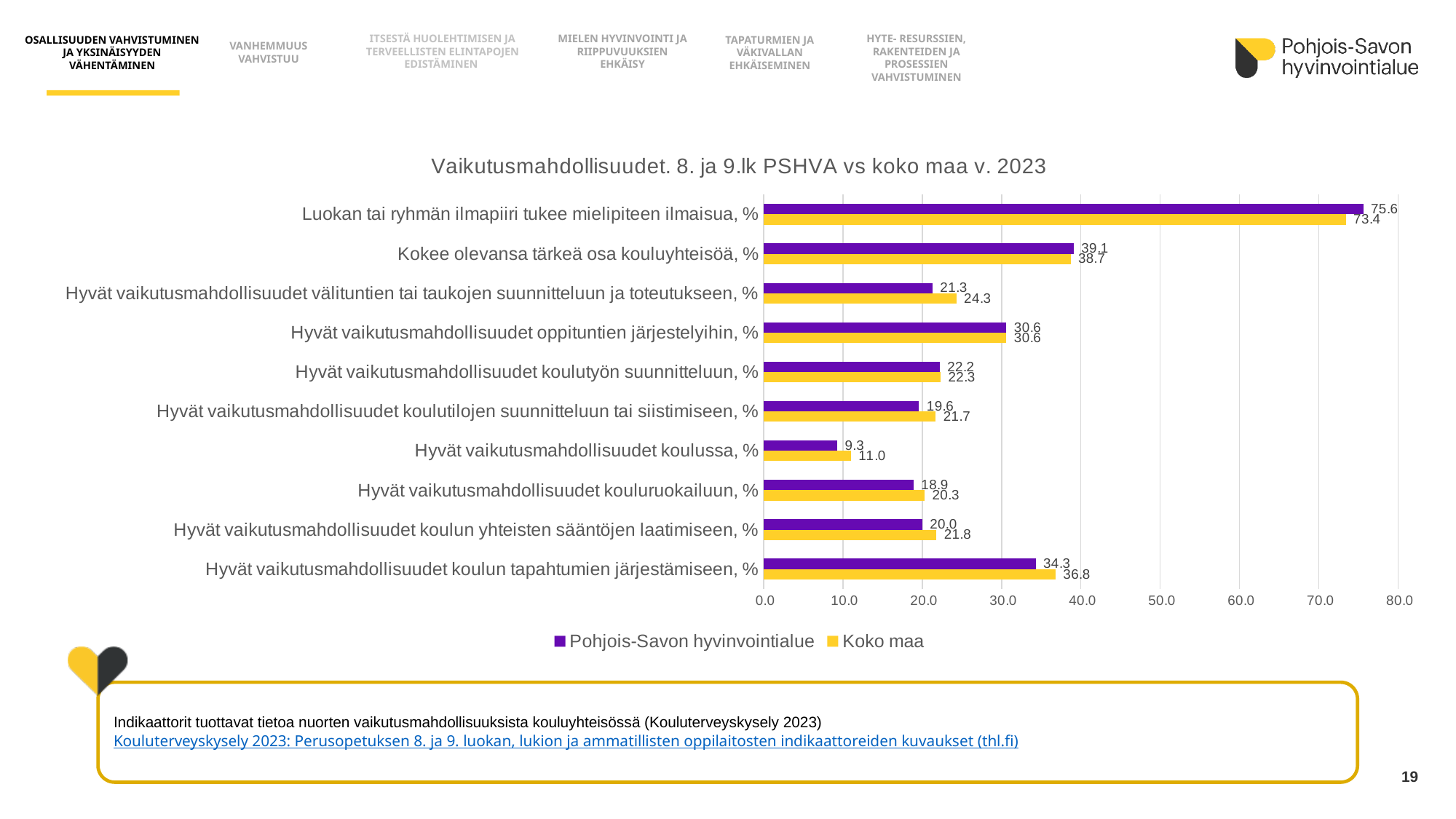
Is the Pohjois-Savon hyvinvointialue value for "Kokee olevansa tärkeä osa kouluyhteisöä, %" greater or less than 30.0? greater What is the difference between the Koko maa and Pohjois-Savon hyvinvointialue values for "Hyvät vaikutusmahdollisuudet välituntien tai taukojen suunnitteluun ja toteutukseen, %"? 3.0 Which category has the highest value for Pohjois-Savon hyvinvointialue? Luokan tai ryhmän ilmapiiri tukee mielipiteen ilmaisua, % What type of chart is shown on the slide? Bar chart Which category has the lowest value for Koko maa? Hyvät vaikutusmahdollisuudet koulussa, % What is the value for Pohjois-Savon hyvinvointialue for "Luokan tai ryhmän ilmapiiri tukee mielipiteen ilmaisua, %"? 75.6 What is the Koko maa value for "Hyvät vaikutusmahdollisuudet koulun tapahtumien järjestämiseen, %"? 36.8 What is the title of the chart? Vaikutusmahdollisuudet. 8. ja 9.lk PSHVA vs koko maa v. 2023 How many series does the legend list? 2 How many categories are shown on the chart? 10 What is the Koko maa value for "Hyvät vaikutusmahdollisuudet koulussa, %"? 11.0 For "Hyvät vaikutusmahdollisuudet kouluruokailuun, %", which series has the larger value, Pohjois-Savon hyvinvointialue or Koko maa? Koko maa